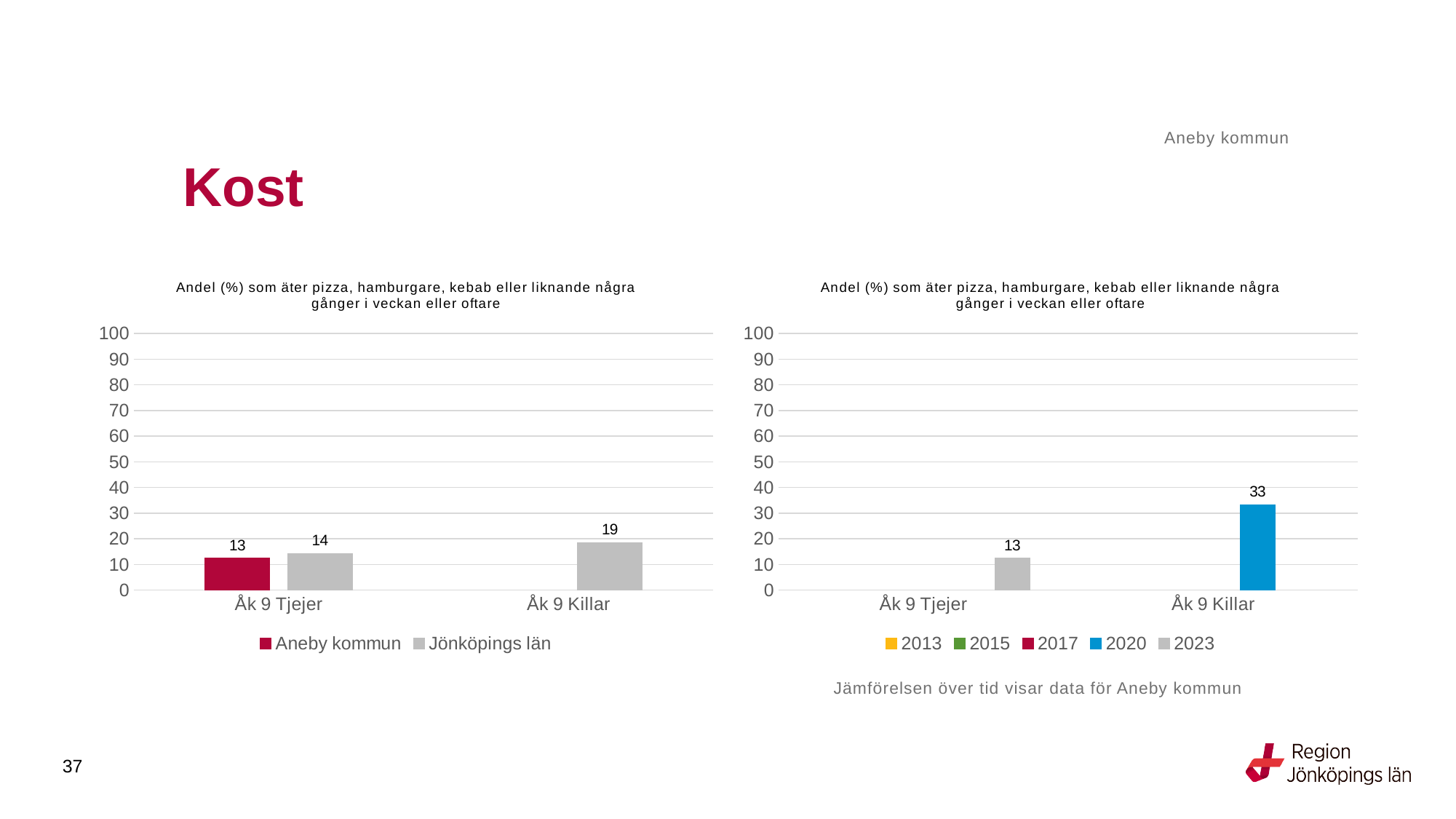
In the right chart, is the 2020 value for Åk 9 Killar greater or less than 30? greater In the right chart, how many series does the legend list? 5 In the right chart, what is the 2020 value for Åk 9 Killar? 33 In the left chart, what is the value for Aneby kommun for Åk 9 Tjejer? 13 In the right chart, what is the 2023 value for Åk 9 Tjejer? 13 In the left chart, what is the difference between the Jönköpings län values for Åk 9 Killar and Åk 9 Tjejer? 5 In the left chart, how many series does the legend list? 2 In the left chart, which category has the highest Jönköpings län value? Åk 9 Killar In the left chart, what is the value for Jönköpings län for Åk 9 Killar? 19 What kind of chart is the right chart? bar chart How many categories are shown on the x axis of the left chart? 2 In the left chart, what is the value for Jönköpings län for Åk 9 Tjejer? 14